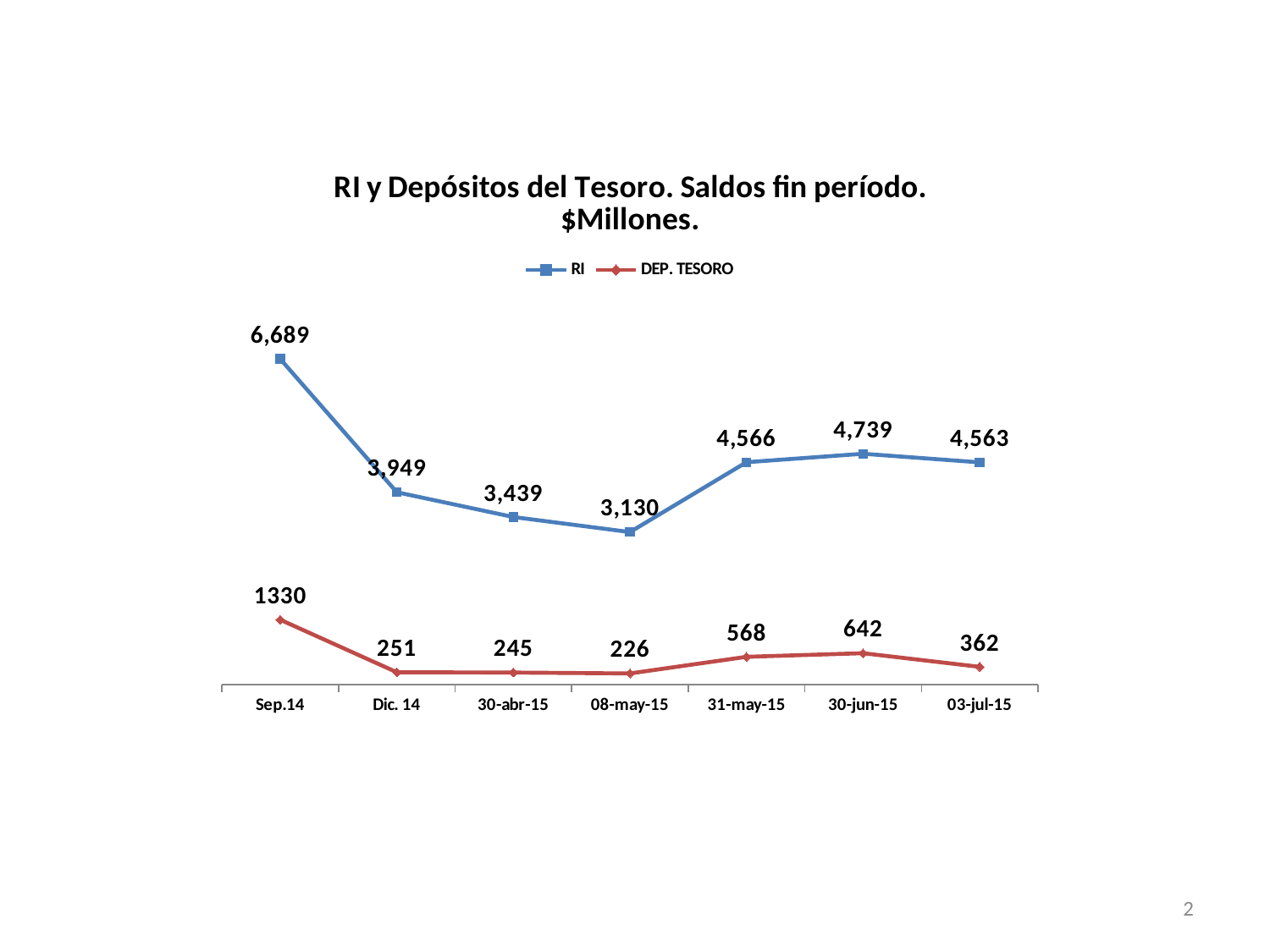
What is the DEP. TESORO value at 03-jul-15? 362 What is the RI value at Sep.14? 6,689 Does the RI series rise or fall from Sep.14 to 08-may-15? Fall What is the difference between the RI values at Sep.14 and Dic. 14? 2,740 How many series does the legend list? 2 What kind of chart is this? Line chart Which is larger, the RI value at 30-jun-15 or at 03-jul-15? 30-jun-15 What is the RI value at 08-may-15? 3,130 What is the DEP. TESORO value at 30-jun-15? 642 At which date is the DEP. TESORO series highest? Sep.14 How many dates are shown on the x axis? 7 At which date is the RI series lowest? 08-may-15